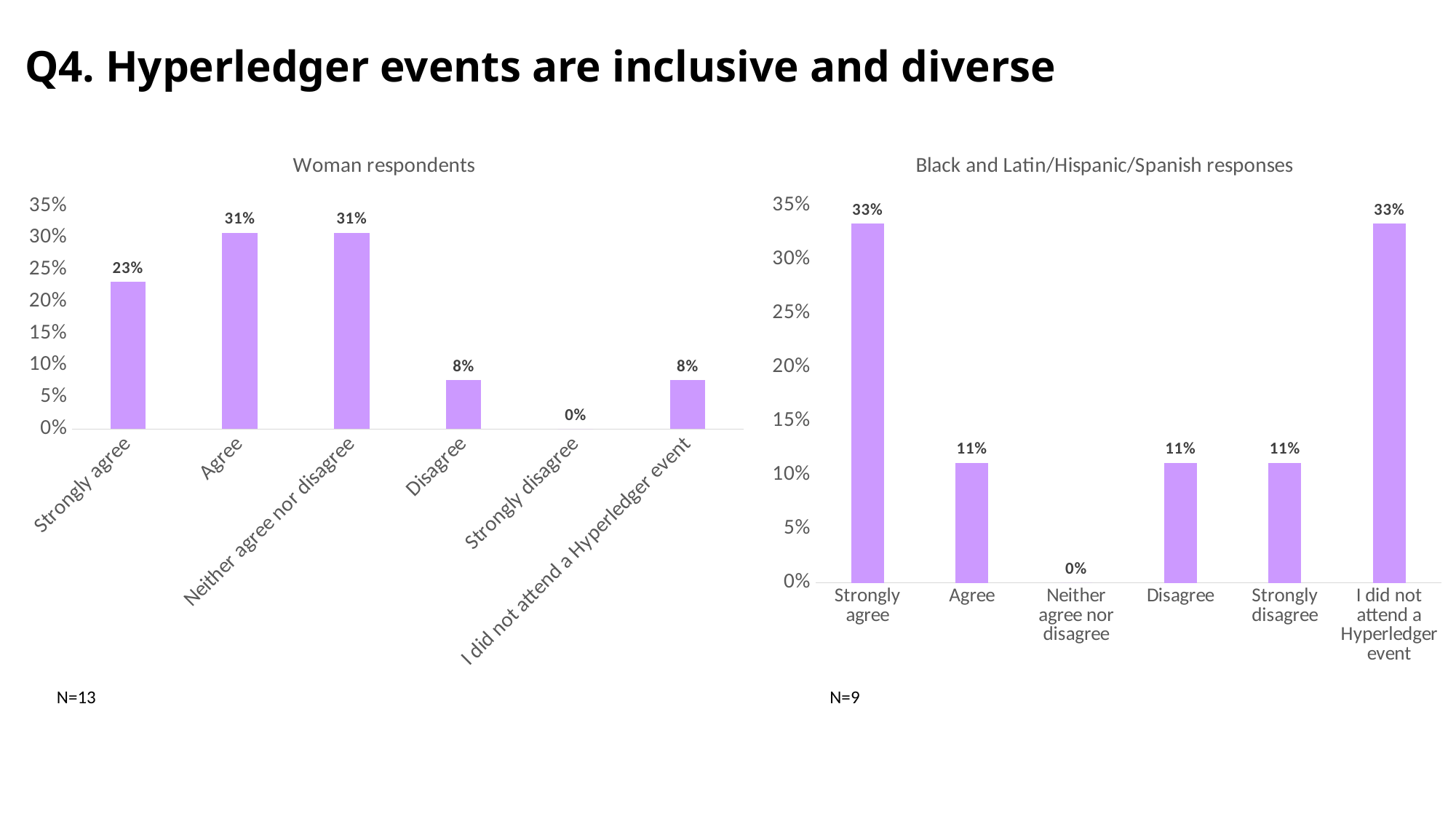
In the 'Woman respondents' chart, what is the difference between Agree and Strongly agree? 8% In the 'Woman respondents' chart, what is the value for Disagree? 8% In the 'Woman respondents' chart, how many categories are shown on the x axis? 6 What kind of chart is the 'Woman respondents' chart? Bar chart In the 'Black and Latin/Hispanic/Spanish responses' chart, what is the difference between Strongly agree and Disagree? 22% In the 'Woman respondents' chart, what is the value for Strongly agree? 23% In the 'Black and Latin/Hispanic/Spanish responses' chart, what is the value for Neither agree nor disagree? 0% In the 'Black and Latin/Hispanic/Spanish responses' chart, what is the value for Agree? 11% What is the N value shown below the 'Black and Latin/Hispanic/Spanish responses' chart? N=9 In the 'Black and Latin/Hispanic/Spanish responses' chart, is the value for Strongly agree greater or less than 30%? greater In the 'Woman respondents' chart, which category has the lowest value? Strongly disagree In the 'Black and Latin/Hispanic/Spanish responses' chart, which is larger, Strongly agree or Strongly disagree? Strongly agree